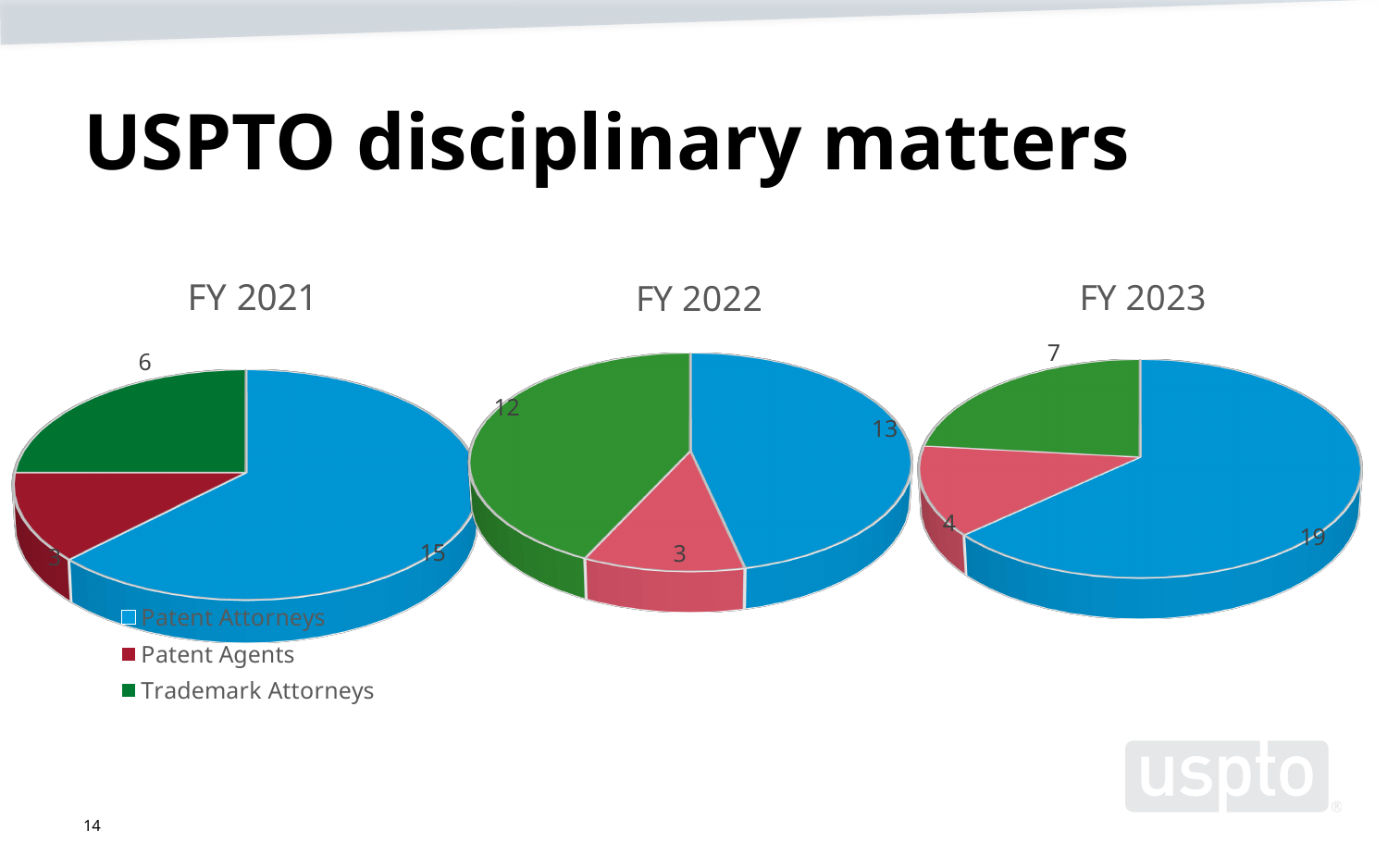
In the FY 2022 chart, which category has the smallest slice? Patent Agents How many series does the legend list? 3 How many slices does the FY 2021 chart have? 3 In the FY 2022 chart, what is the value for Trademark Attorneys? 12 In the FY 2022 chart, which is larger: Patent Attorneys or Trademark Attorneys? Patent Attorneys In the FY 2021 chart, what is the value for Patent Attorneys? 15 What kind of charts are shown on the slide? Pie charts In the FY 2023 chart, which category has the largest slice? Patent Attorneys In the FY 2021 chart, what is the difference between the Patent Attorneys value and the Trademark Attorneys value? 9 In the FY 2023 chart, what is the value for Patent Agents? 4 In the FY 2023 chart, what is the difference between Patent Attorneys and Trademark Attorneys? 12 In the FY 2021 chart, what share of the total do Trademark Attorneys represent? 25%